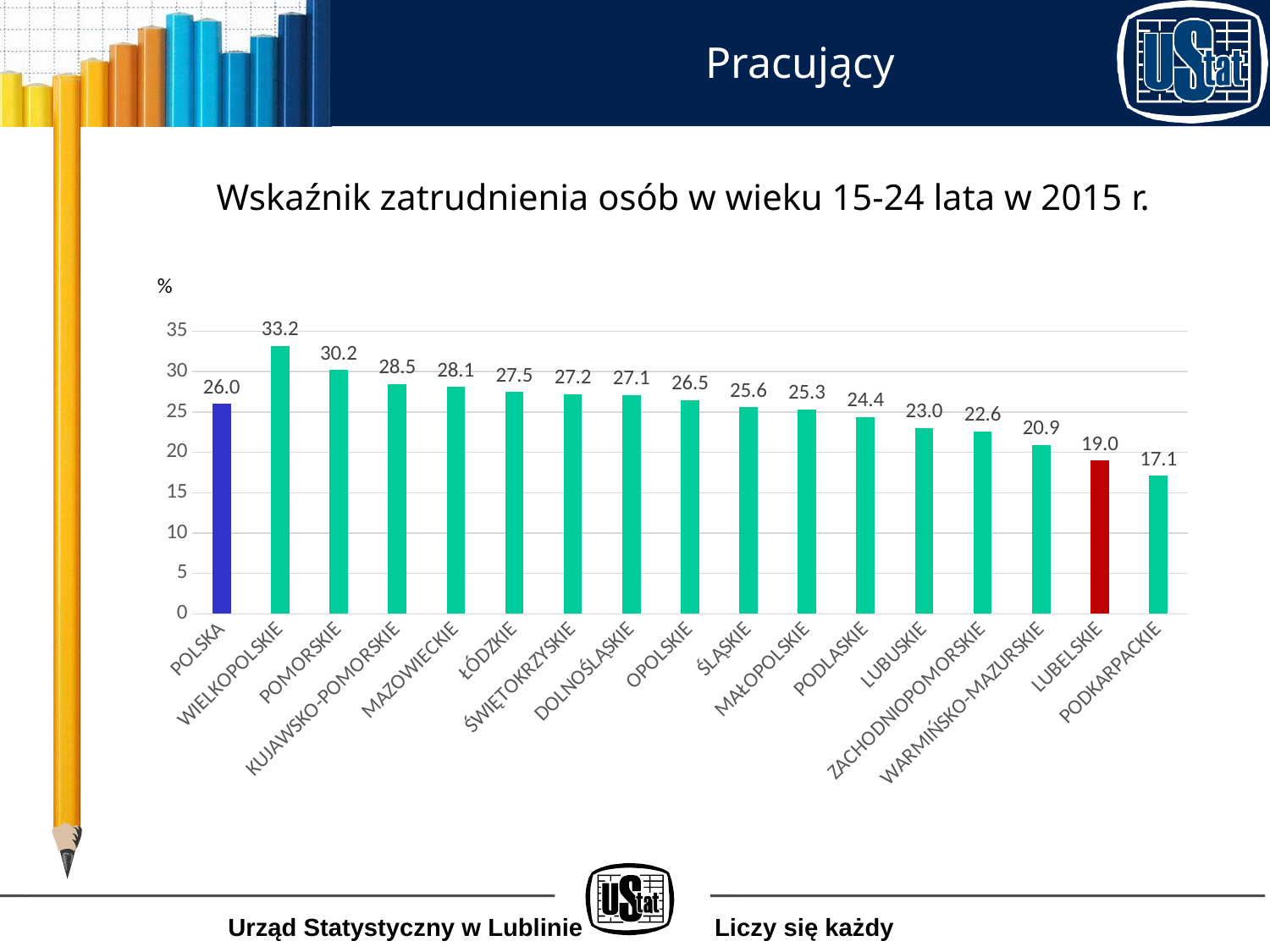
How many categories are shown on the x axis? 17 Which category has the lowest value? PODKARPACKIE Is the value for PODKARPACKIE greater or less than 20? less What is the value for LUBELSKIE? 19.0 What is the difference between the values for POLSKA and LUBELSKIE? 7.0 Which category has the highest value? WIELKOPOLSKIE What kind of chart is shown on the slide? bar chart What is the value for MAZOWIECKIE? 28.1 Which is larger, the value for POMORSKIE or the value for LUBUSKIE? POMORSKIE What is the difference between the values for WIELKOPOLSKIE and LUBELSKIE? 14.2 What is the value for POLSKA? 26.0 What is the title of the chart? Wskaźnik zatrudnienia osób w wieku 15-24 lata w 2015 r.